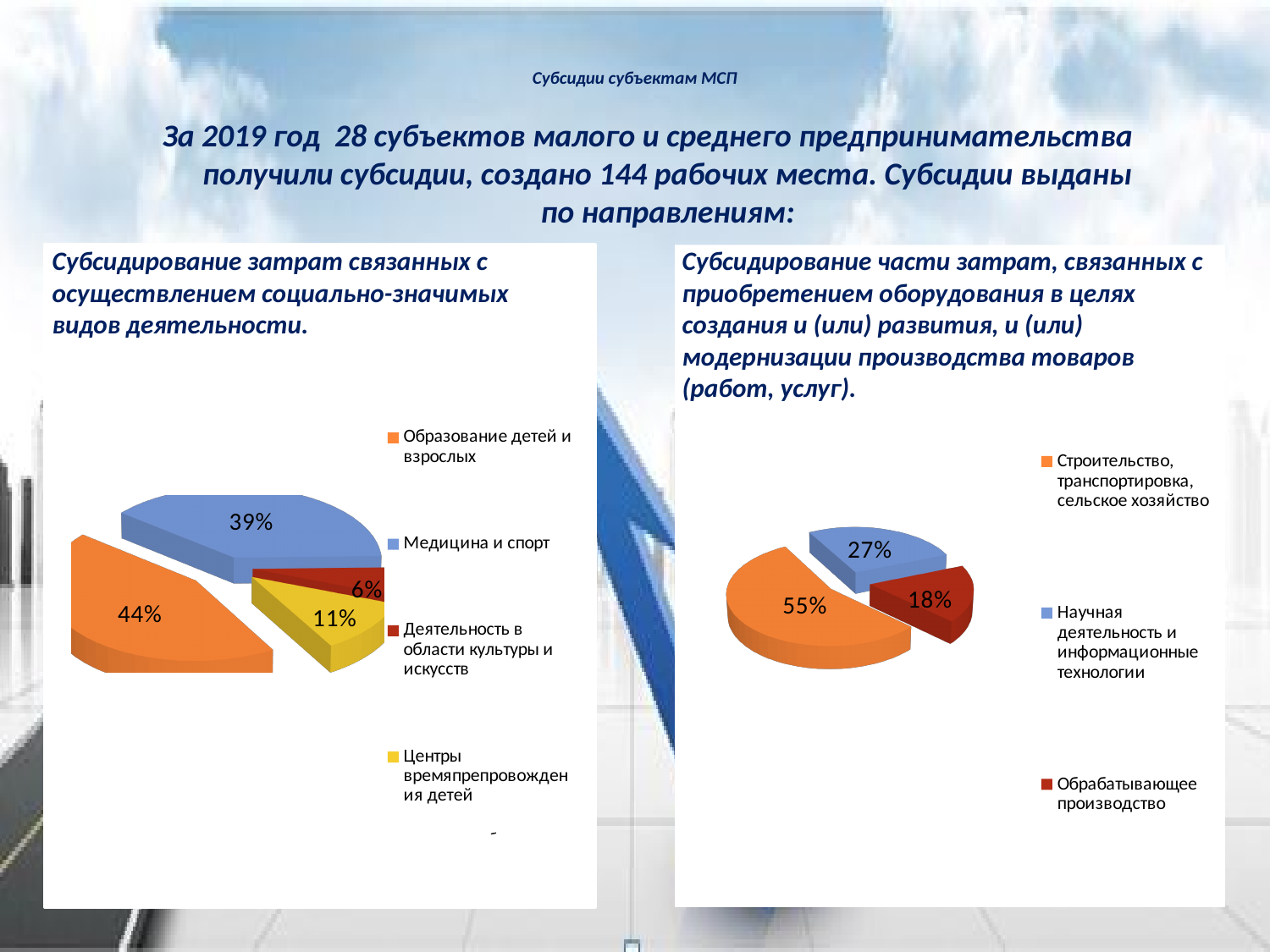
On the left chart (social-significant activities), what share is shown for Медицина и спорт? 39% What type of chart is used on the right side of the slide? Pie chart On the left chart (social-significant activities), which category has the largest share? Образование детей и взрослых On the left chart (social-significant activities), how many categories does the legend list? 4 On the left chart (social-significant activities), what share is shown for Центры времяпрепровождения детей? 11% On the right chart (equipment purchase), what share is shown for Строительство, транспортировка, сельское хозяйство? 55% On the right chart (equipment purchase), how many slices does the pie have? 3 On the right chart (equipment purchase), what share is shown for Обрабатывающее производство? 18% On the right chart (equipment purchase), which is larger: Научная деятельность и информационные технологии or Обрабатывающее производство? Научная деятельность и информационные технологии On the left chart (social-significant activities), which category has the smallest share? Деятельность в области культуры и искусств On the left chart (social-significant activities), what is the difference between the shares of Образование детей и взрослых and Медицина и спорт? 5% On the left chart (social-significant activities), what share is shown for Образование детей и взрослых? 44%